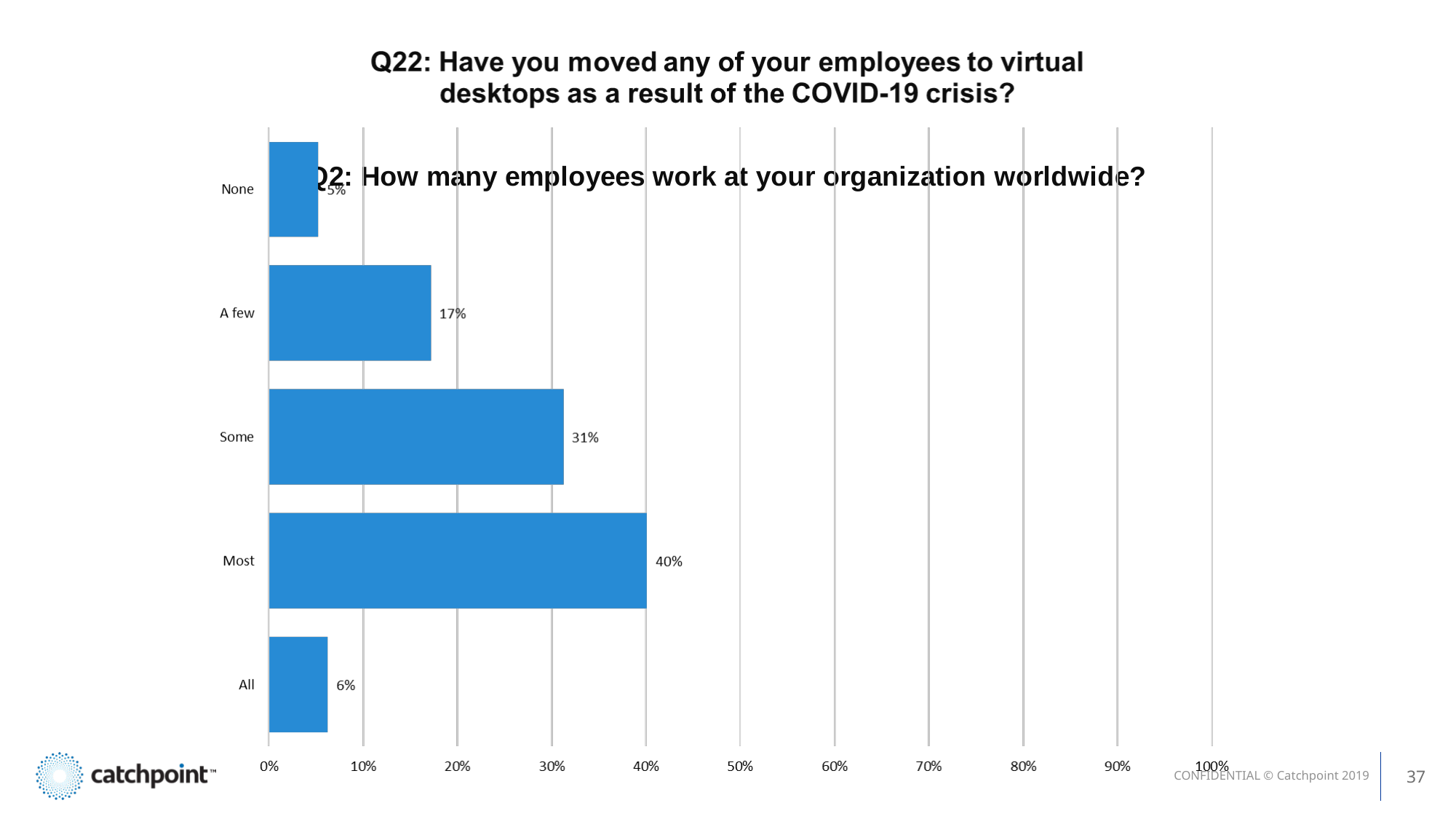
Which response category has the highest percentage? Most Which has a larger percentage, "A few" or "All"? A few What percentage of respondents answered "Most"? 40% What percentage of respondents answered "Some"? 31% What is the difference in percentage points between "Most" and "Some"? 9 How many response categories are shown in the chart? 5 What is the highest value shown on the percentage axis? 100% What percentage of respondents answered "All"? 6% Which response category has the lowest percentage? None What type of chart is shown on the slide? Bar chart What percentage of respondents answered "A few"? 17% Is the value for "None" greater or less than 10%? less